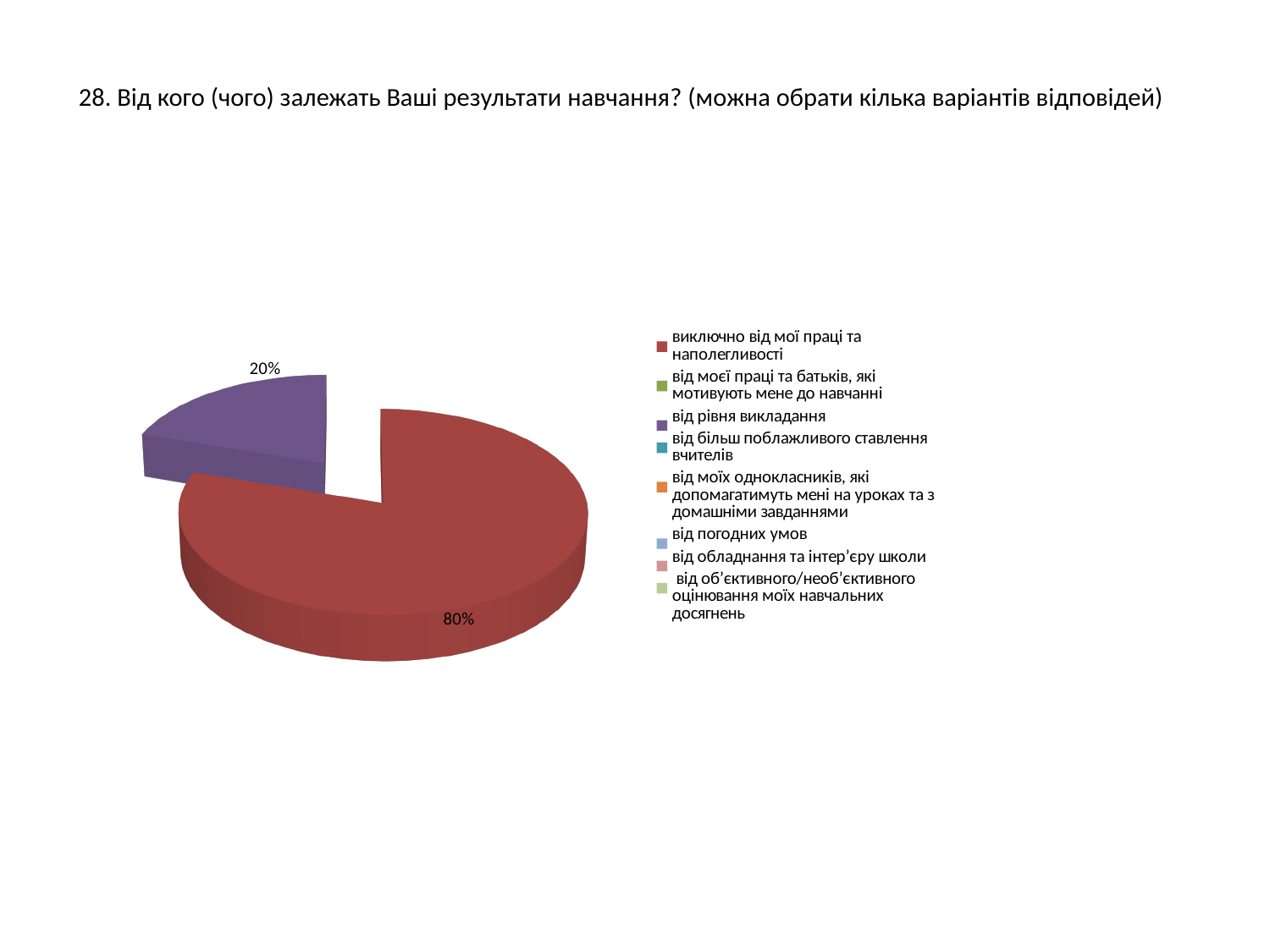
What colour is the slice labelled 20%? purple What share of the pie does the slice "від рівня викладання" take? 20% Which category has the largest slice of the pie? виключно від мої праці та наполегливості Which of the two visible slices is smaller, "від рівня викладання" or "виключно від мої праці та наполегливості"? від рівня викладання Is the slice for "виключно від мої праці та наполегливості" larger or smaller than the slice for "від рівня викладання"? larger What share of the pie does the slice "виключно від мої праці та наполегливості" take? 80% What is the total of the two labelled slices in the pie chart? 100% How many entries does the legend list? 8 How many slices with data labels are visible in the pie chart? 2 What kind of chart is shown on the slide? pie chart What is the difference in percentage points between the 80% slice and the 20% slice? 60 What colour is the slice labelled 80%? red